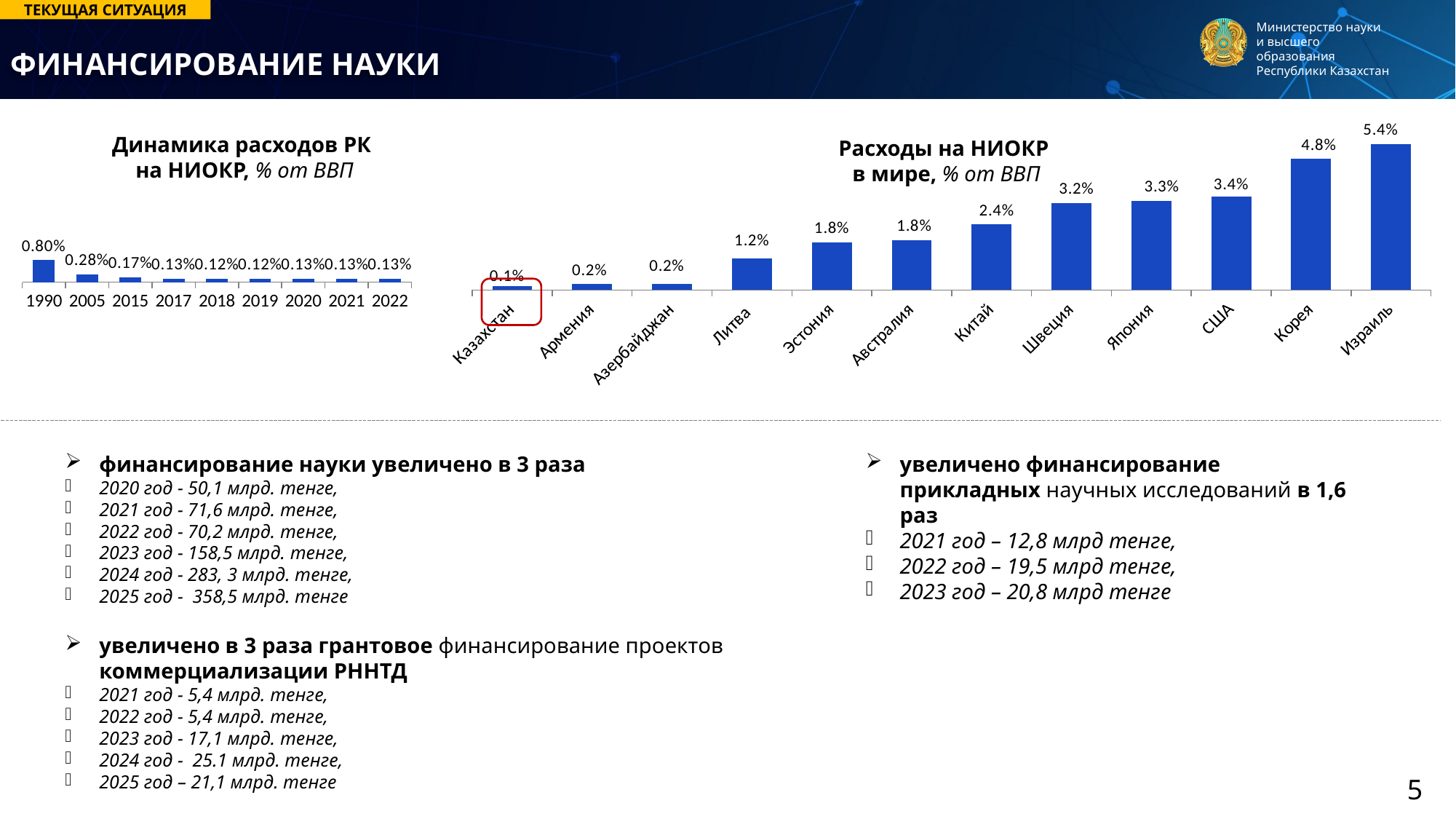
На диаграмме «Расходы на НИОКР в мире, % от ВВП» на сколько процентных пунктов значение Израиля больше значения Швеции? 2.2% На диаграмме «Расходы на НИОКР в мире, % от ВВП» какое значение указано для Китая? 2.4% На диаграмме «Динамика расходов РК на НИОКР, % от ВВП» сколько лет (категорий) показано? 9 На диаграмме «Расходы на НИОКР в мире, % от ВВП» сколько стран показано? 12 На диаграмме «Динамика расходов РК на НИОКР, % от ВВП» какое значение указано для 1990 года? 0.80% На диаграмме «Динамика расходов РК на НИОКР, % от ВВП» в каком году значение наибольшее? 1990 На диаграмме «Динамика расходов РК на НИОКР, % от ВВП» какое значение указано для 2022 года? 0.13% На диаграмме «Динамика расходов РК на НИОКР, % от ВВП» на сколько процентных пунктов значение 1990 года больше значения 2005 года? 0.52% На диаграмме «Расходы на НИОКР в мире, % от ВВП» какое значение указано для Кореи? 4.8% Какого типа диаграмма «Расходы на НИОКР в мире, % от ВВП»? Столбчатая (bar chart) На диаграмме «Расходы на НИОКР в мире, % от ВВП» какая страна имеет наибольшее значение? Израиль На диаграмме «Расходы на НИОКР в мире, % от ВВП» какая страна имеет наименьшее значение? Казахстан